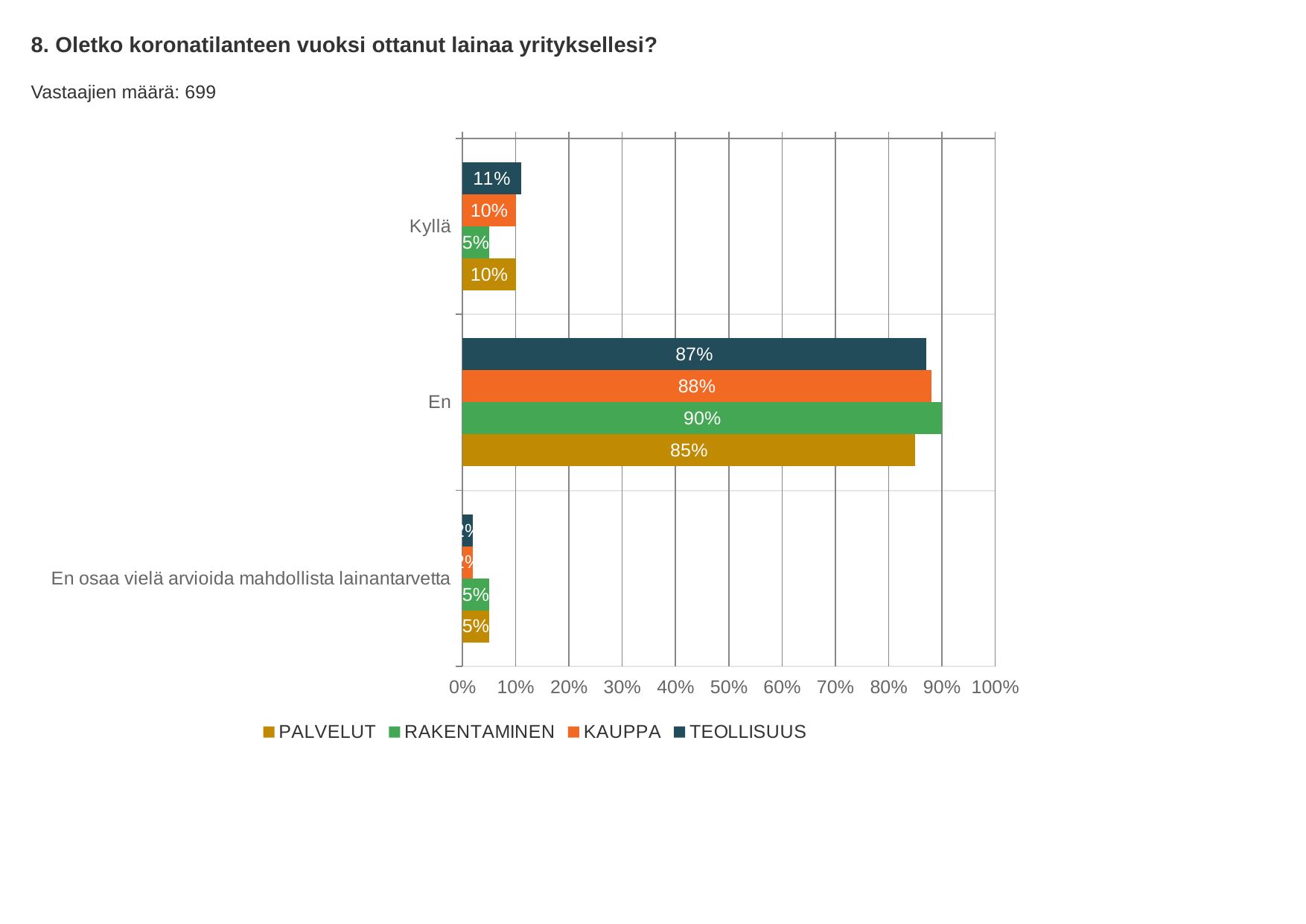
What is the difference between the RAKENTAMINEN and PALVELUT values in the En category? 5% Which series has the lowest value in the Kyllä category? RAKENTAMINEN What kind of chart is shown on the slide? bar chart Which series has the highest value in the En category? RAKENTAMINEN How many categories are shown on the chart? 3 Is the value for TEOLLISUUS in the En osaa vielä arvioida mahdollista lainantarvetta category greater or less than 10%? less What is the value for RAKENTAMINEN in the En category? 90% What is the value for PALVELUT in the En category? 85% What is the value for TEOLLISUUS in the Kyllä category? 11% How many series does the legend list? 4 What is the value for KAUPPA in the Kyllä category? 10% Which is larger in the Kyllä category: the value for TEOLLISUUS or the value for RAKENTAMINEN? TEOLLISUUS